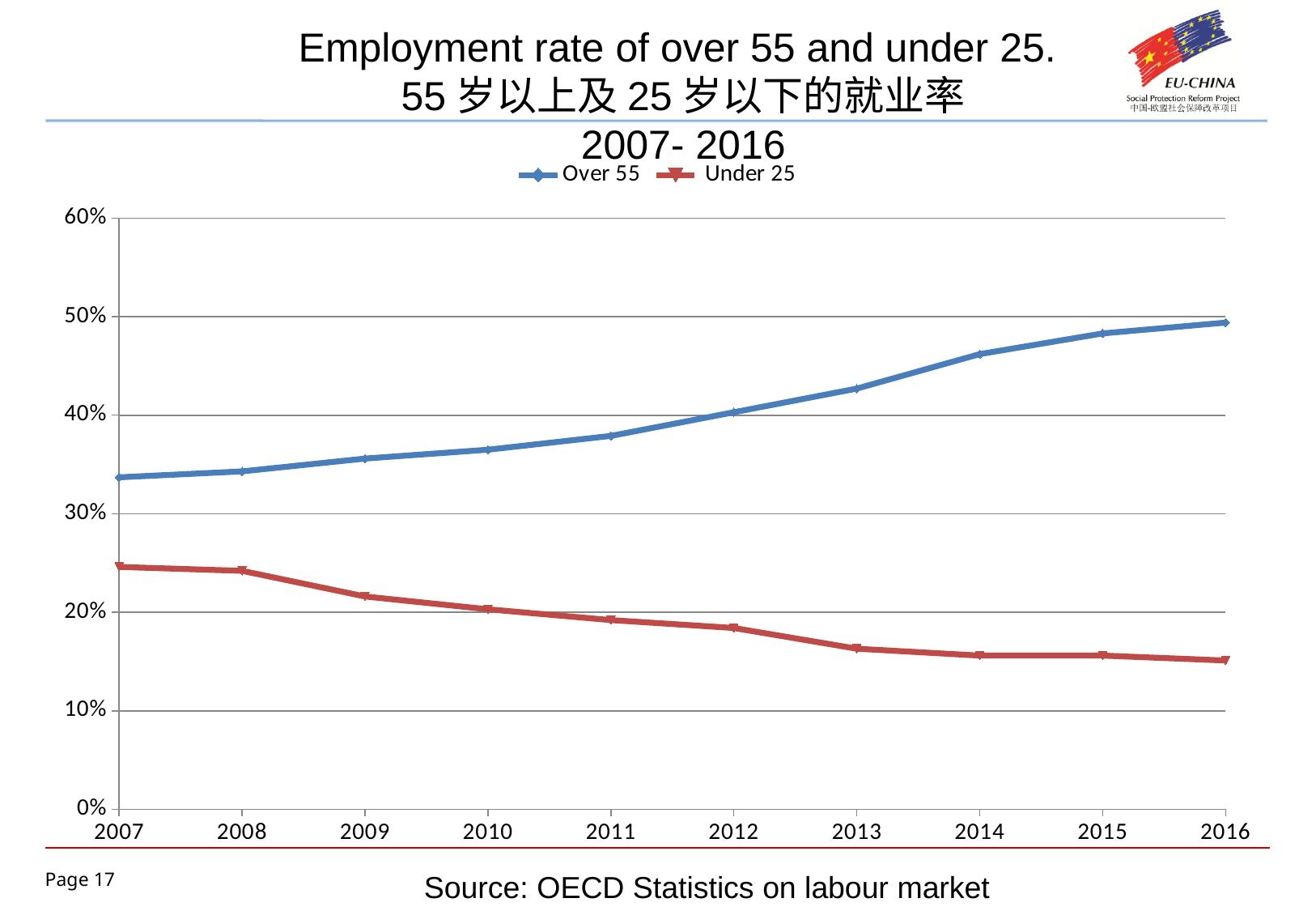
What kind of chart is shown on the slide? line chart Is the value for Under 25 in 2016 greater or less than 20%? less How many series does the legend list? 2 Is the value for Over 55 in 2007 greater or less than 30%? greater In which year is the Over 55 employment rate lowest? 2007 Which series has the larger value in 2010, Over 55 or Under 25? Over 55 Is the value for Over 55 in 2013 greater or less than 40%? greater How many years are plotted along the x axis? 10 Does the employment rate for Over 55 rise or fall from 2007 to 2016? rise In which year is the Over 55 employment rate highest? 2016 Does the employment rate for Under 25 rise or fall from 2007 to 2016? fall In which year is the Under 25 employment rate highest? 2007